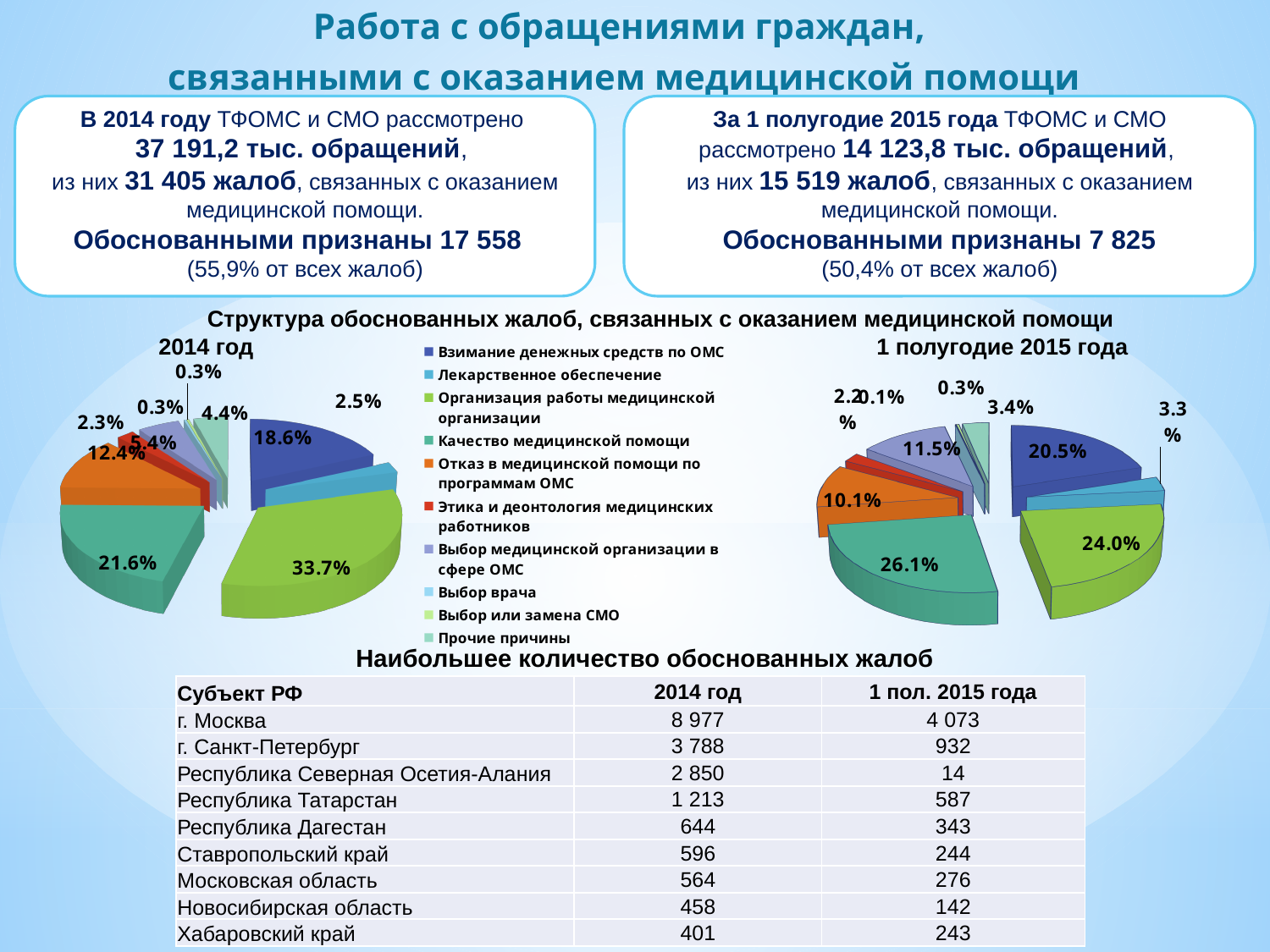
In the 2014 год pie chart, which category has the largest share? Организация работы медицинской организации In the 2014 год pie chart, what share is shown for Взимание денежных средств по ОМС? 18.6% In the 2014 год pie chart, what share is shown for Качество медицинской помощи? 21.6% In the 1 полугодие 2015 года pie chart, what share is shown for Качество медицинской помощи? 26.1% In the 1 полугодие 2015 года pie chart, what share is shown for Взимание денежных средств по ОМС? 20.5% In the 1 полугодие 2015 года pie chart, which category has the largest share? Качество медицинской помощи In the 1 полугодие 2015 года pie chart, what share is shown for Отказ в медицинской помощи по программам ОМС? 10.1% What kind of chart is used for the 2014 год structure of justified complaints? pie chart In the 1 полугодие 2015 года pie chart, which is larger: Качество медицинской помощи or Организация работы медицинской организации? Качество медицинской помощи In the 2014 год pie chart, what share is shown for Организация работы медицинской организации? 33.7% How many categories does the shared legend of the pie charts list? 10 In the 2014 год pie chart, by how many percentage points does Организация работы медицинской организации exceed Качество медицинской помощи? 12.1 percentage points